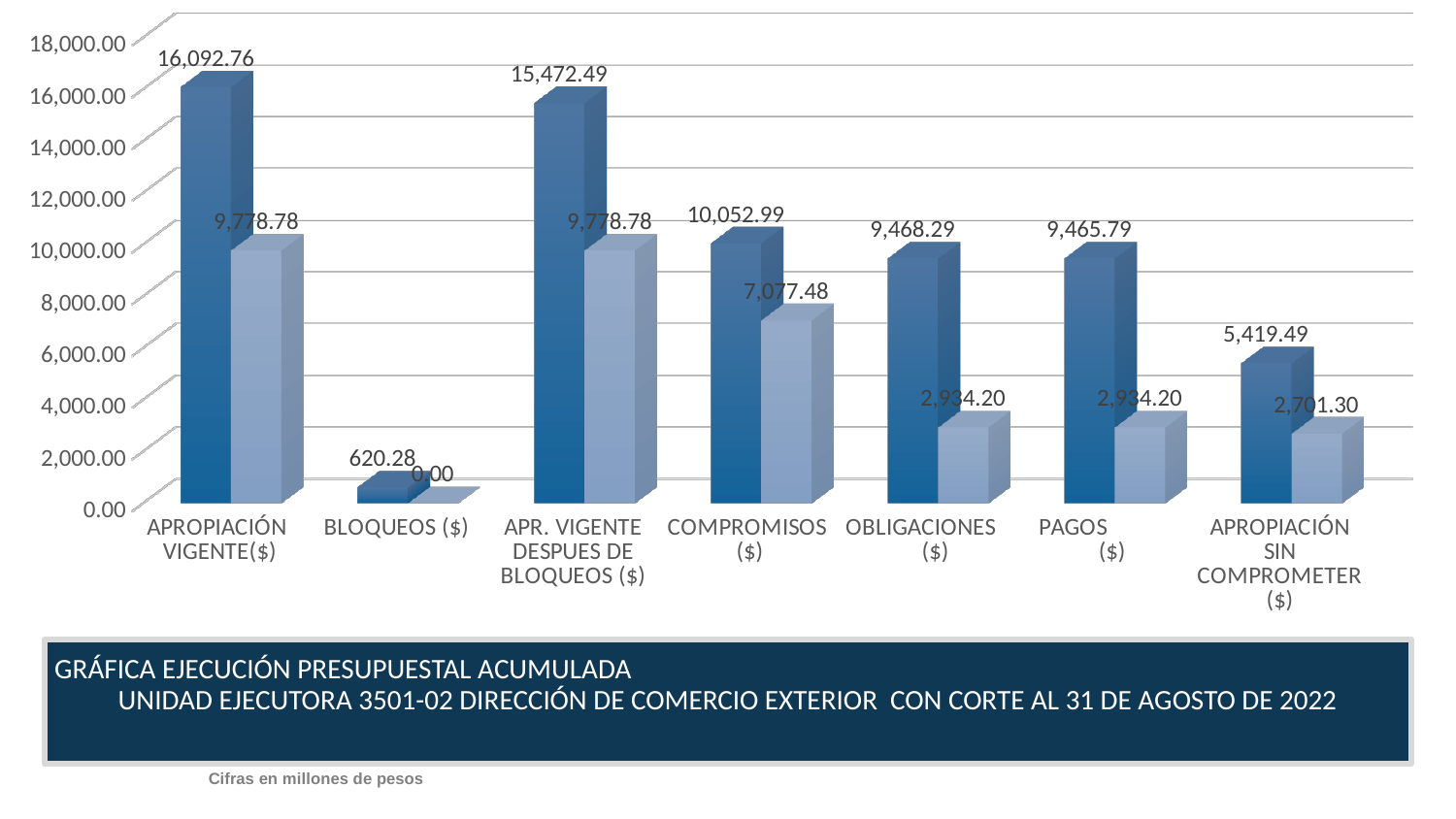
What is the value of the light blue bar for COMPROMISOS ($)? 7,077.48 Which dark blue bar is larger: COMPROMISOS ($) or APROPIACIÓN SIN COMPROMETER ($)? COMPROMISOS ($) How many categories are shown on the x axis? 7 What is the value of the light blue bar for OBLIGACIONES ($)? 2,934.20 Is the dark blue bar for PAGOS ($) greater or less than 8,000.00? greater Which category has the highest dark blue bar? APROPIACIÓN VIGENTE($) For COMPROMISOS ($), what is the difference between the dark blue bar and the light blue bar? 2,975.51 What is the value of the dark blue bar for BLOQUEOS ($)? 620.28 Which category has the lowest light blue bar? BLOQUEOS ($) What is the value of the dark blue bar for APROPIACIÓN VIGENTE($)? 16,092.76 What is the difference between the dark blue bars for APROPIACIÓN VIGENTE($) and APR. VIGENTE DESPUES DE BLOQUEOS ($)? 620.27 What kind of chart is shown on the slide? bar chart